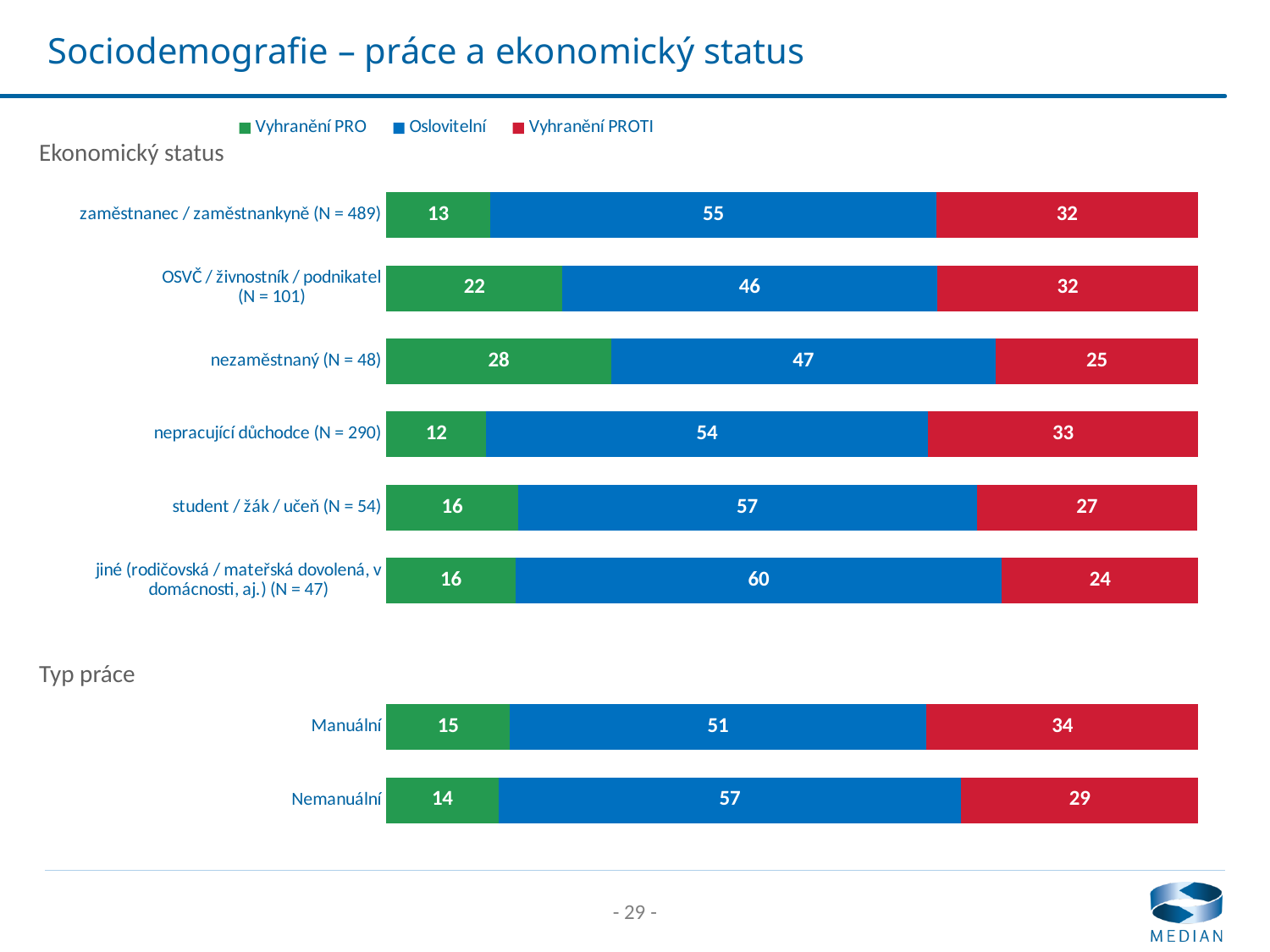
In the Ekonomický status chart, which is larger: the Oslovitelní value for student / žák / učeň (N = 54) or for OSVČ / živnostník / podnikatel (N = 101)? student / žák / učeň (N = 54) In the Ekonomický status chart, what is the Vyhranění PRO value for nezaměstnaný (N = 48)? 28 In the Typ práce chart, what is the Vyhranění PROTI value for Manuální? 34 In the Typ práce chart, what is the total of the Nemanuální bar? 100 What kind of chart is the Typ práce chart? stacked bar chart In the Ekonomický status chart, what is the difference between the Vyhranění PROTI values for nepracující důchodce (N = 290) and jiné (rodičovská / mateřská dovolená, v domácnosti, aj.) (N = 47)? 9 Which colour represents Vyhranění PROTI in the legend? red How many categories does the Ekonomický status chart show? 6 In the Ekonomický status chart, what is the Oslovitelní value for zaměstnanec / zaměstnankyně (N = 489)? 55 In the Ekonomický status chart, which category has the highest Vyhranění PRO value? nezaměstnaný (N = 48) How many series does the legend list? 3 In the Ekonomický status chart, which category has the lowest Vyhranění PRO value? nepracující důchodce (N = 290)